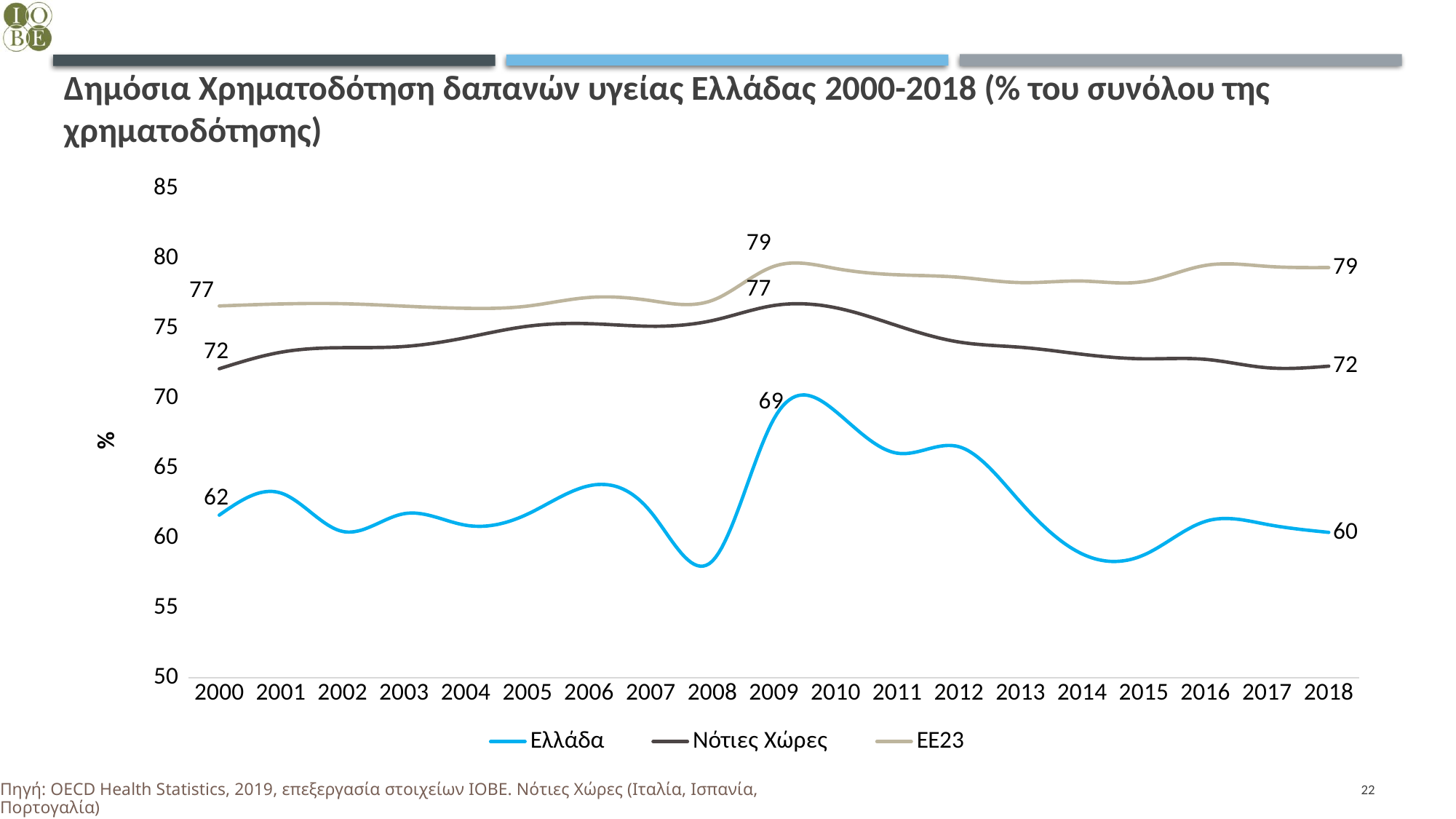
What is the value for Ελλάδα in 2009? 69 What type of chart is shown on the slide? line chart How many series does the legend list? 3 Which series has the highest value in 2018? ΕΕ23 Is the value for Ελλάδα in 2008 greater or less than 60? less How many years are shown on the x axis? 19 What is the value for ΕΕ23 in 2009? 79 What is the difference between the Νότιες Χώρες value in 2009 and in 2018? 5 What is the value for Νότιες Χώρες in 2018? 72 What is the difference between the ΕΕ23 value and the Ελλάδα value in 2018? 19 Which series has the lowest value in 2000? Ελλάδα What is the value for Ελλάδα in 2000? 62